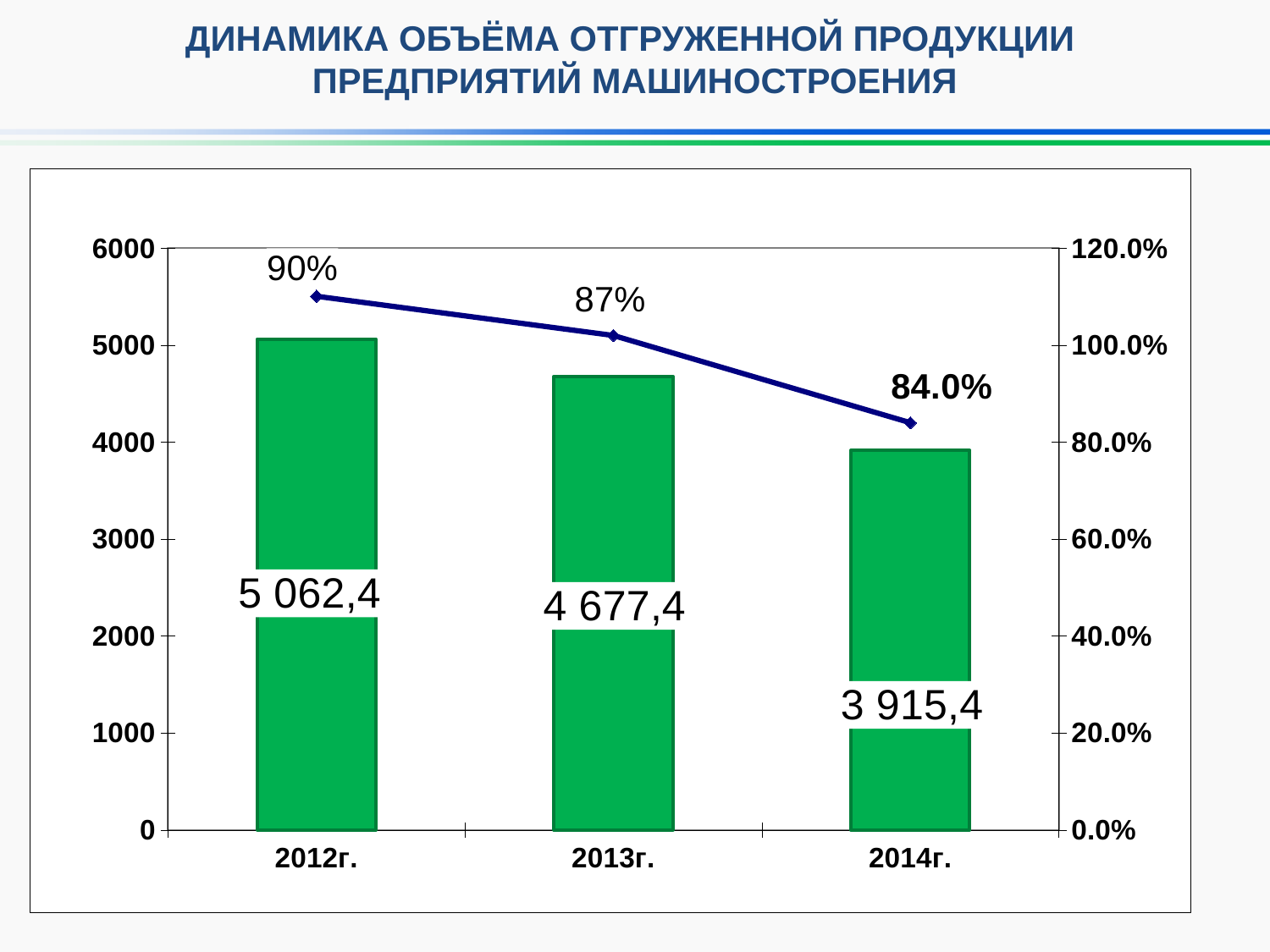
What is the bar value for 2012г.? 5 062,4 Which year has the highest bar value? 2012г. How many years are shown on the x axis? 3 Do the bar values rise or fall from 2012г. to 2014г.? fall What is the bar value for 2014г.? 3 915,4 What percentage is shown on the line for 2012г.? 90% Which year has the lowest bar value? 2014г. What percentage is shown on the line for 2014г.? 84.0% Which is larger, the bar value for 2013г. or for 2014г.? 2013г. What is the bar value for 2013г.? 4 677,4 What is the difference between the bar values for 2013г. and 2014г.? 762,0 What is the difference between the bar values for 2012г. and 2013г.? 385,0